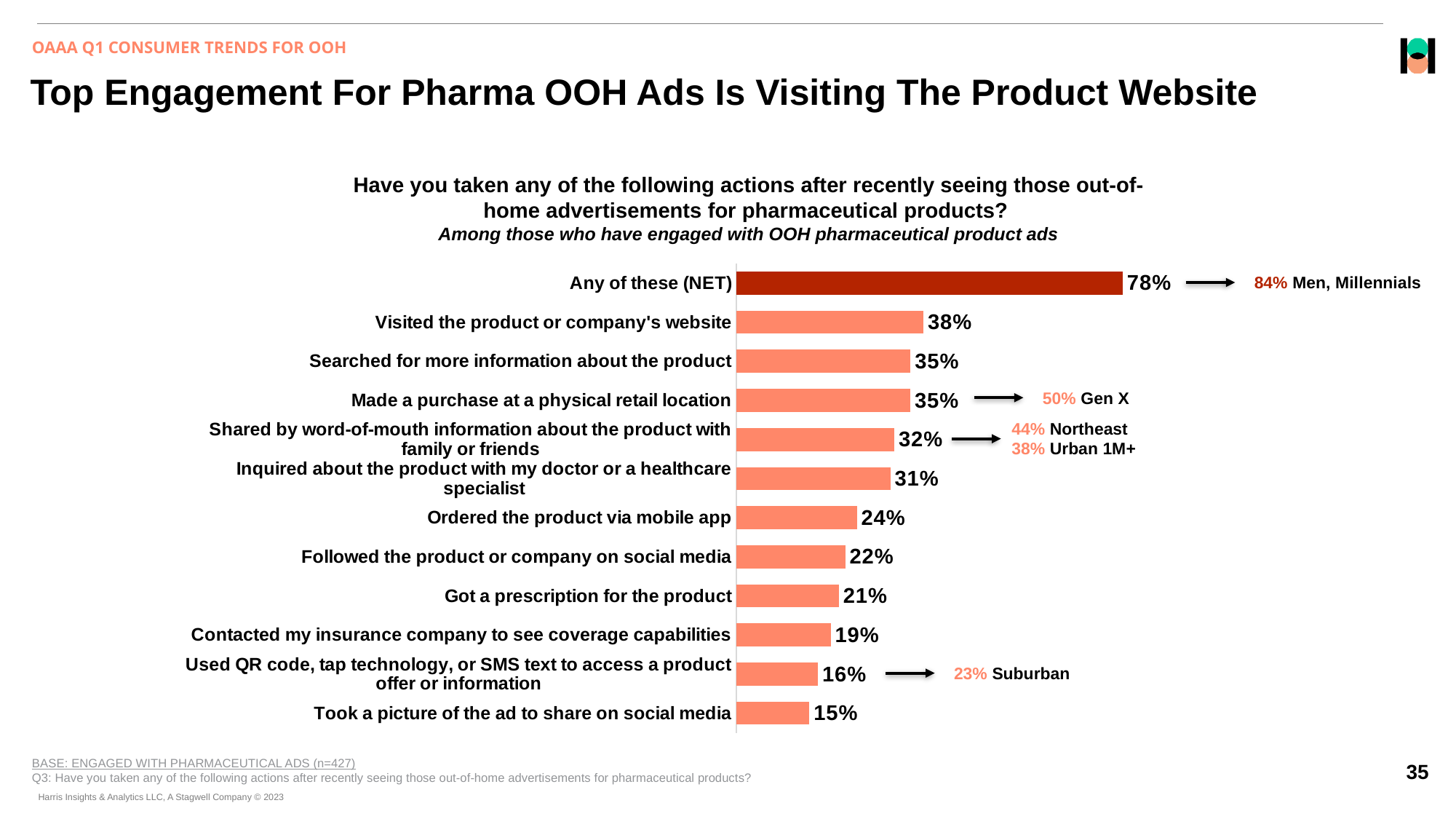
What kind of chart is shown on the slide? Bar chart What percentage of Gen X made a purchase at a physical retail location, according to the callout? 50% What is the value for 'Any of these (NET)'? 78% How many bars are shown in the chart, including the NET bar? 12 Which is larger: 'Followed the product or company on social media' or 'Contacted my insurance company to see coverage capabilities'? Followed the product or company on social media Which action has the lowest percentage? Took a picture of the ad to share on social media Excluding the NET bar, which action has the highest percentage? Visited the product or company's website What percentage of respondents visited the product or company's website? 38% What percentage took a picture of the ad to share on social media? 15% What percentage got a prescription for the product? 21% What percentage of Suburban respondents used QR code, tap technology, or SMS text, according to the callout? 23% What is the difference between 'Visited the product or company's website' and 'Ordered the product via mobile app'? 14%